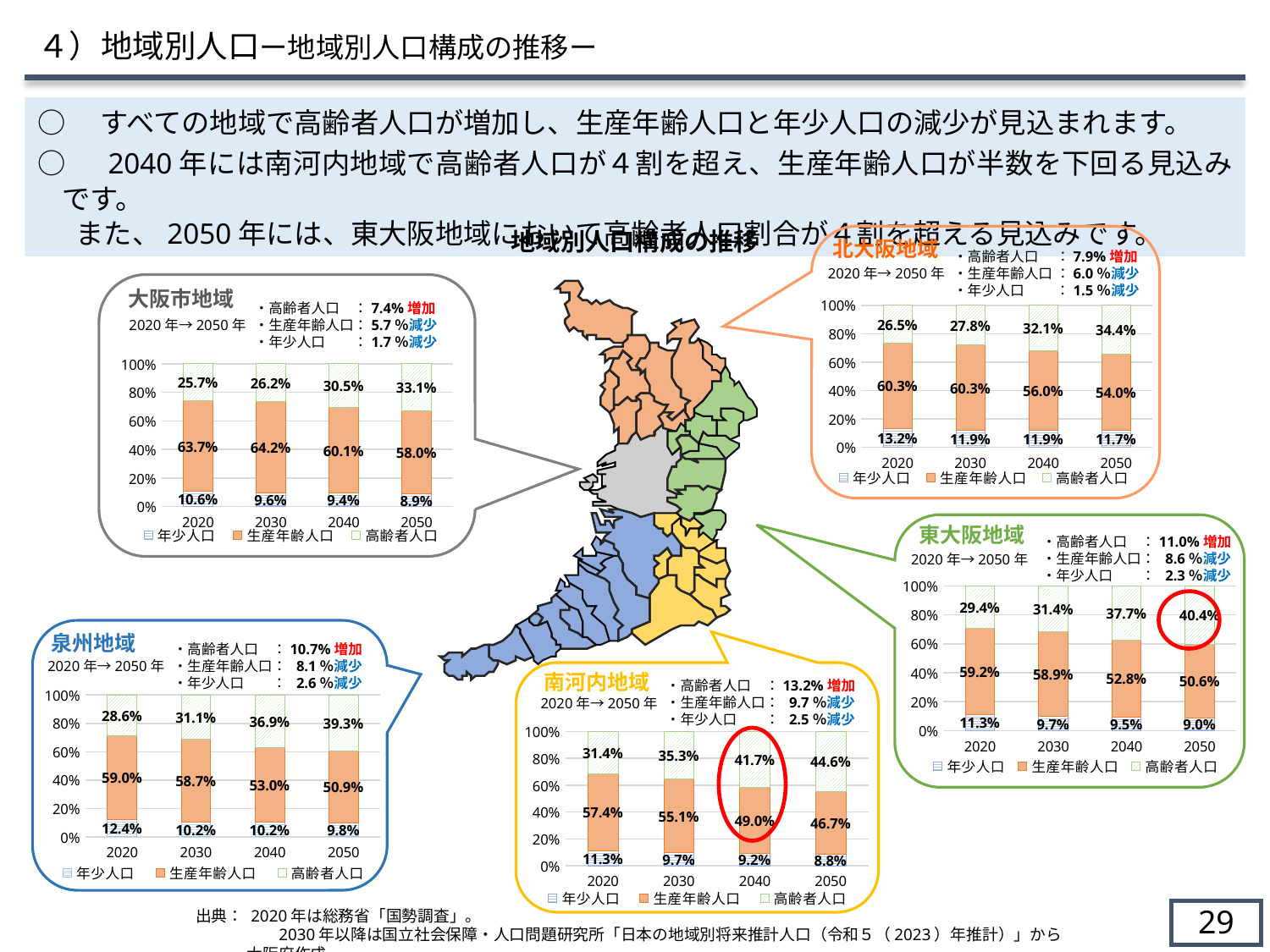
In the 南河内地域 chart, what is the value for 高齢者人口 in 2040? 41.7% In the 東大阪地域 chart, which is larger: 高齢者人口 in 2050 or 生産年齢人口 in 2050? 生産年齢人口 in 2050 In the 南河内地域 chart, what is the difference between the 生産年齢人口 values for 2020 and 2050? 10.7% In the 東大阪地域 chart, what is the value for 生産年齢人口 in 2050? 50.6% In the 南河内地域 chart, does the value for 高齢者人口 rise or fall from 2020 to 2050? Rise In the 泉州地域 chart, what is the total of the stacked bar for 2020? 100% In the 泉州地域 chart, how many years are shown on the x axis? 4 In the 大阪市地域 chart, what is the value for 年少人口 in 2020? 10.6% In the 泉州地域 chart, which year has the lowest value for 年少人口? 2050 What kind of chart is the 大阪市地域 chart? Stacked bar chart In the 北大阪地域 chart, which year has the highest value for 高齢者人口? 2050 In the 北大阪地域 chart, how many series does the legend list? 3